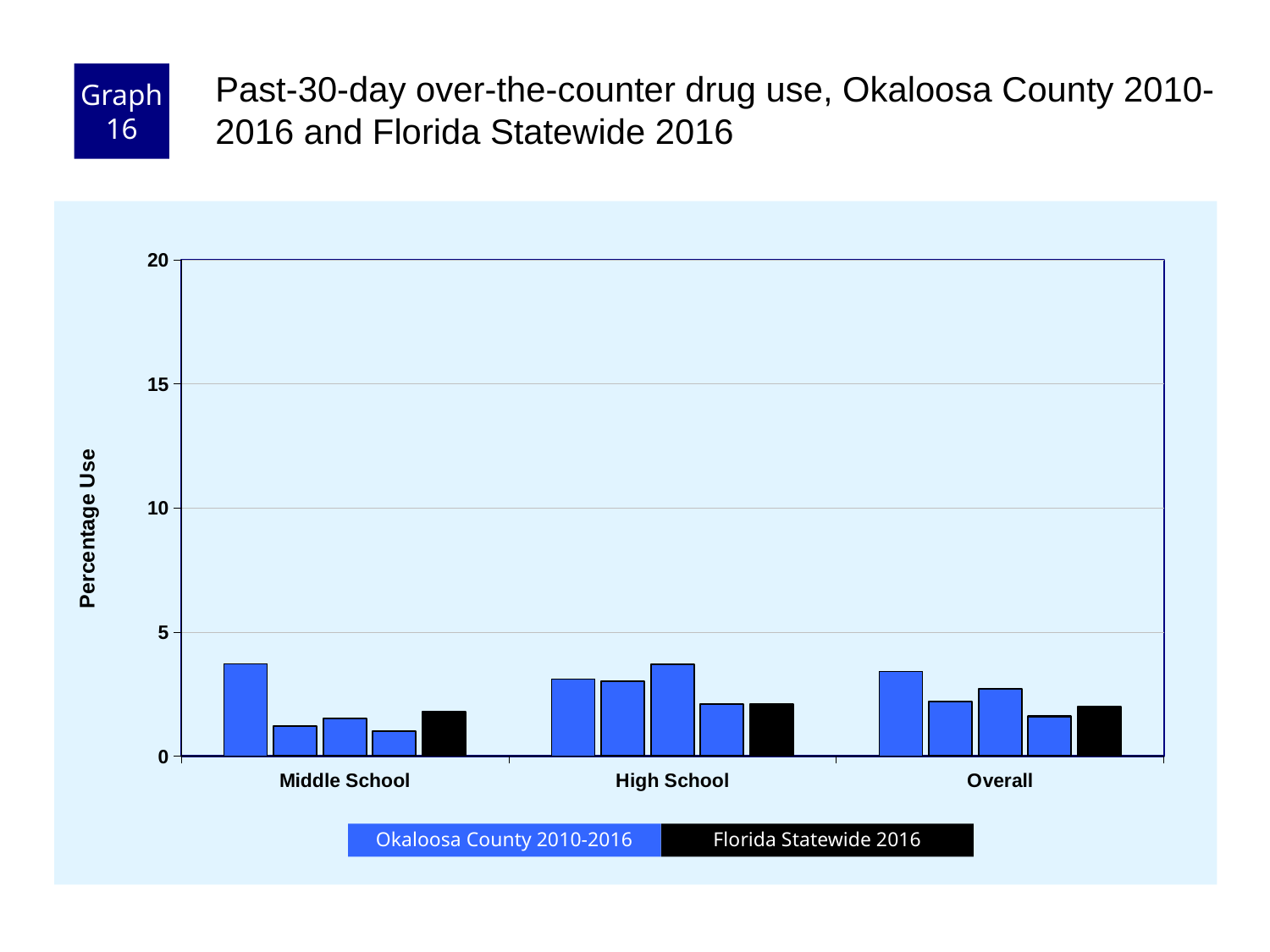
Which colour represents Florida Statewide 2016 in the legend? black Are any of the bars in the chart greater than 5? No What is the highest value shown on the y axis? 20 What is the label on the y axis? Percentage Use Is the Florida Statewide 2016 value for Middle School greater or less than 5? less Is the Florida Statewide 2016 value for High School greater or less than 5? less How many categories are shown on the x axis? 3 How many series does the legend list? 2 What kind of chart is shown on the slide? bar chart